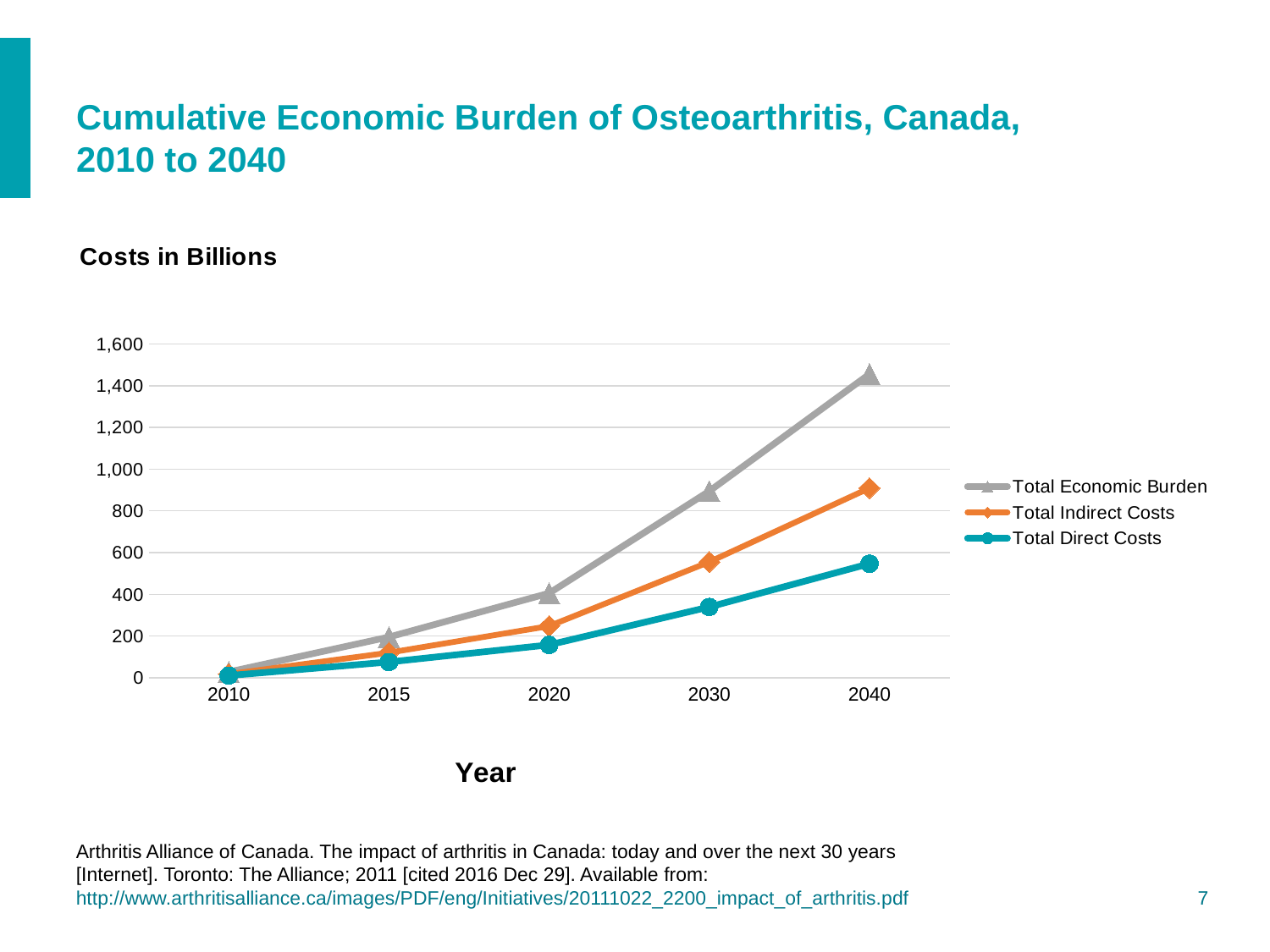
What is the label on the x axis of the chart? Year How many years are plotted along the x axis? 5 In which year is Total Economic Burden highest? 2040 How many series does the legend list? 3 Which series has the lowest value in 2040? Total Direct Costs Do the values for Total Economic Burden rise or fall from 2010 to 2040? Rise Is the value for Total Direct Costs in 2030 greater or less than 400? less In 2040, which is larger: Total Indirect Costs or Total Direct Costs? Total Indirect Costs Which series has the highest value in 2040? Total Economic Burden What kind of chart is shown on the slide? Line chart Is the value for Total Economic Burden in 2040 greater or less than 1,200? greater Is the value for Total Indirect Costs in 2040 greater or less than 800? greater